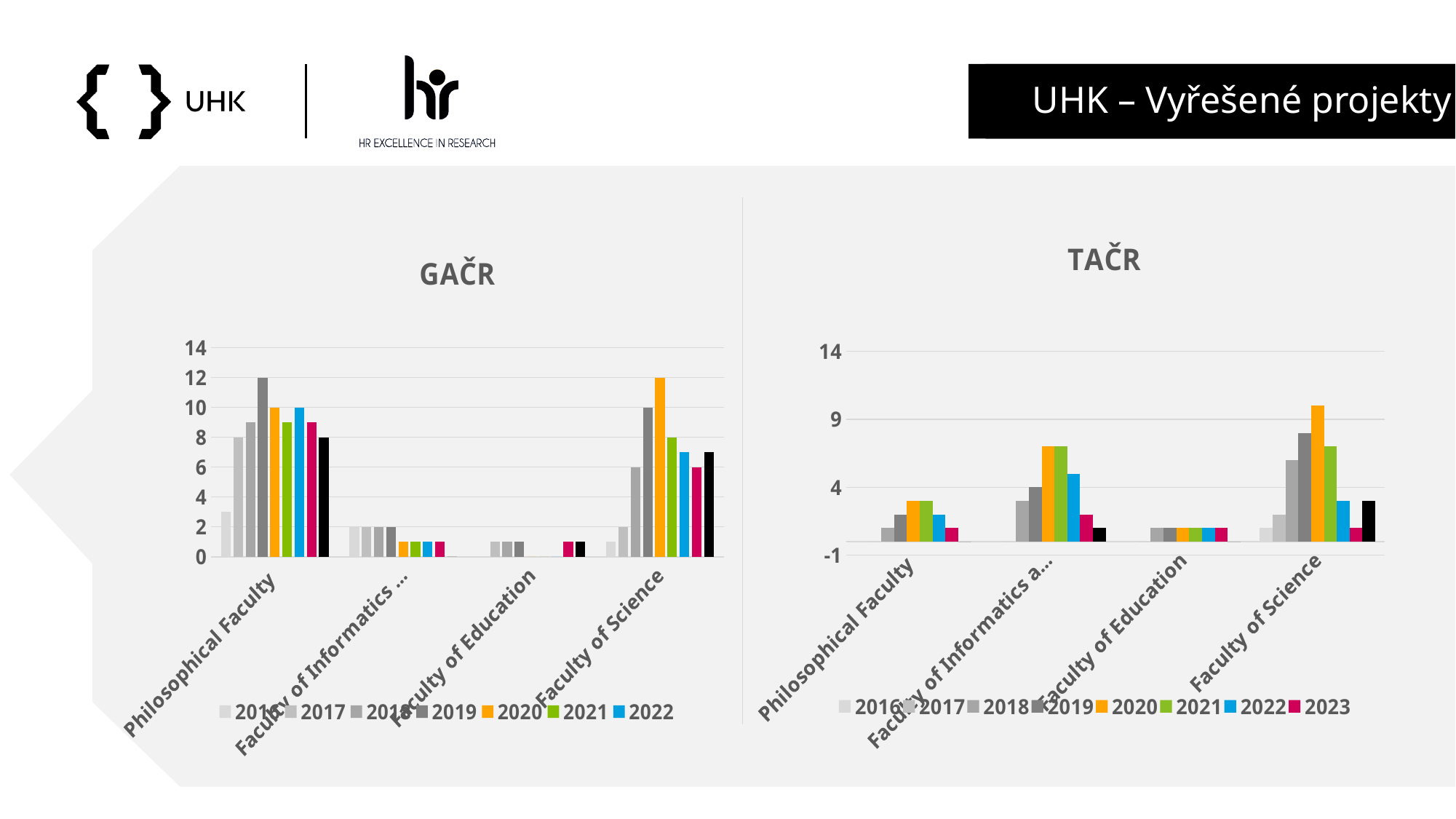
In the TAČR chart, which faculty and year has the highest bar? Faculty of Science, 2020 What is the title of the chart on the right side of the slide? TAČR In the TAČR chart, is the value for Faculty of Science in 2020 greater or less than 9? greater In the GAČR chart, which faculty has the lowest values overall? Faculty of Education In the GAČR chart, is the value for Faculty of Science in 2020 larger than the value for Faculty of Science in 2021? Yes What kind of chart is the GAČR chart? bar chart In the TAČR chart, is the value for Faculty of Education in 2020 greater or less than 4? less How many series does the legend of the TAČR chart list? 8 In the GAČR chart, which year has the highest value for Philosophical Faculty? 2019 How many faculties are shown on the x axis of the TAČR chart? 4 In the GAČR chart, what is the value for Philosophical Faculty in 2019? 12 In the GAČR chart, what is the value for Faculty of Science in 2020? 12